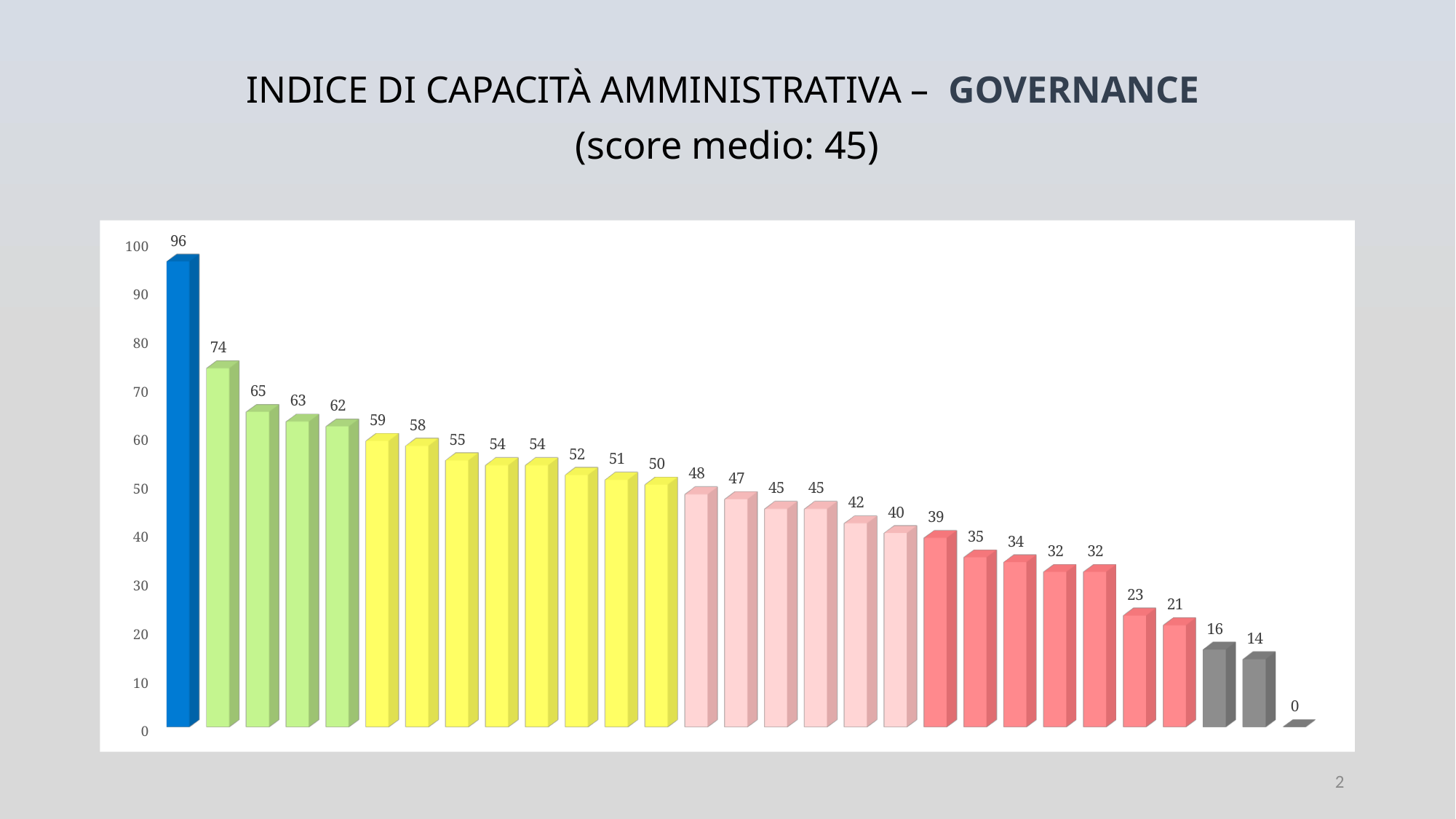
What colour is the tallest bar in the chart? Blue What is the value of the second bar from the left? 74 How many bars are plotted in the chart? 29 What is the value of the first dark red bar (twentieth bar from the left)? 39 What is the value of the tallest bar in the chart? 96 Do the bar values rise or fall from left to right? Fall Which is larger: the value of the blue bar or the value of the first green bar? The blue bar (96) What is the difference between the first bar (96) and the second bar (74)? 22 What is the value of the lowest bar in the chart? 0 What is the value of the first yellow bar (sixth bar from the left)? 59 What kind of chart is shown on the slide? Bar chart What is the average score (score medio) stated in the slide title? 45